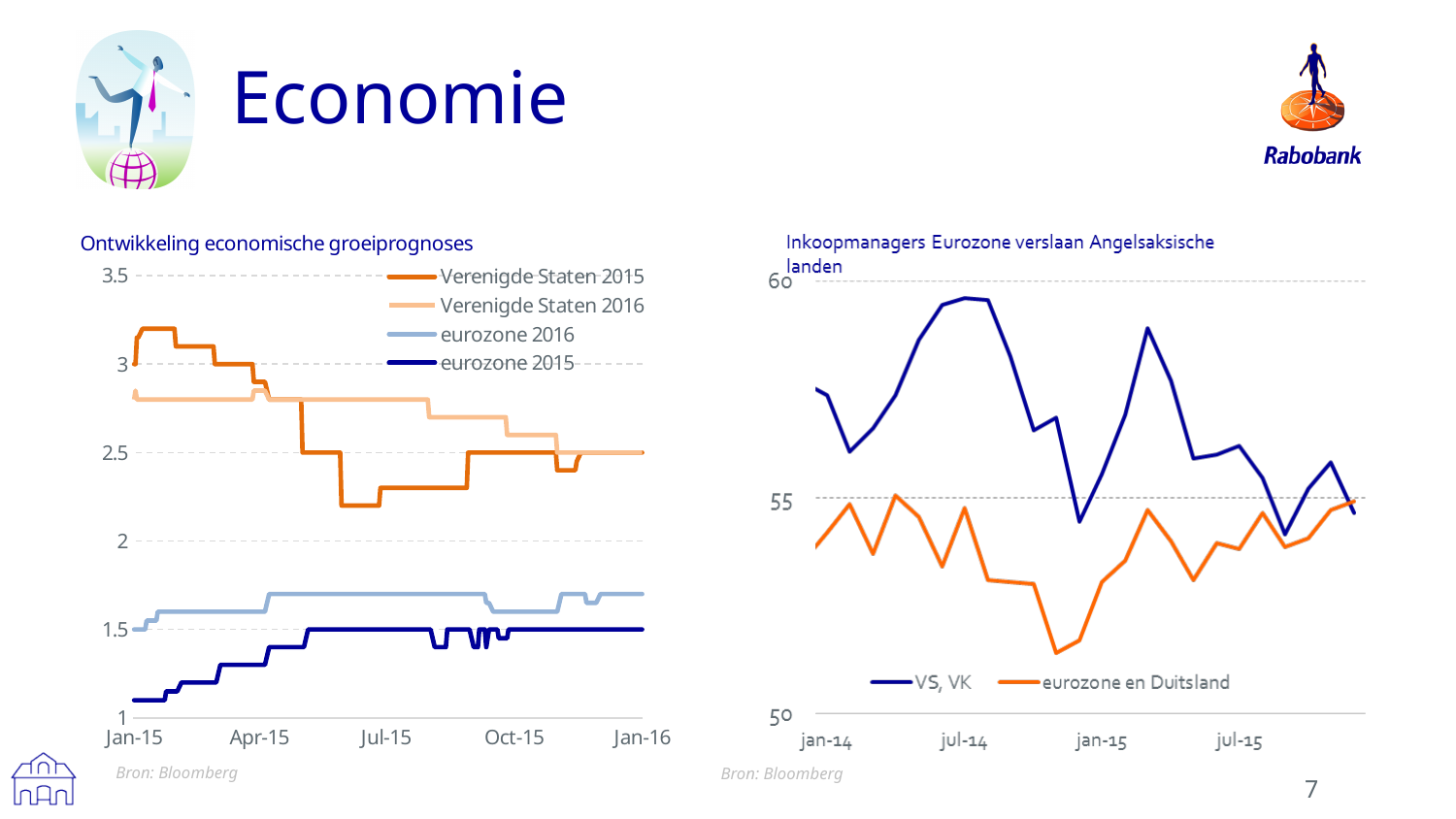
How many series does the legend of the left chart 'Ontwikkeling economische groeiprognoses' list? 4 What source is cited below both charts on the slide? Bron: Bloomberg In the left chart 'Ontwikkeling economische groeiprognoses', is the value for 'eurozone 2015' at Jan-15 greater or less than 1.5? less How many series does the legend of the right chart 'Inkoopmanagers Eurozone verslaan Angelsaksische landen' list? 2 In the left chart 'Ontwikkeling economische groeiprognoses', is the value for 'Verenigde Staten 2015' around Jul-15 greater or less than 2.5? less In the right chart 'Inkoopmanagers Eurozone verslaan Angelsaksische landen', which series is higher around jul-14: 'VS, VK' or 'eurozone en Duitsland'? VS, VK In the left chart 'Ontwikkeling economische groeiprognoses', does the 'Verenigde Staten 2015' series rise or fall from Jan-15 to Jan-16? fall In the left chart 'Ontwikkeling economische groeiprognoses', which series is higher at Jan-15: 'Verenigde Staten 2015' or 'eurozone 2016'? Verenigde Staten 2015 In the right chart 'Inkoopmanagers Eurozone verslaan Angelsaksische landen', is the value for 'VS, VK' around jul-14 greater or less than 55? greater In the left chart 'Ontwikkeling economische groeiprognoses', does the 'eurozone 2015' series rise or fall from Jan-15 to Jan-16? rise What kind of chart is the left chart titled 'Ontwikkeling economische groeiprognoses'? line chart